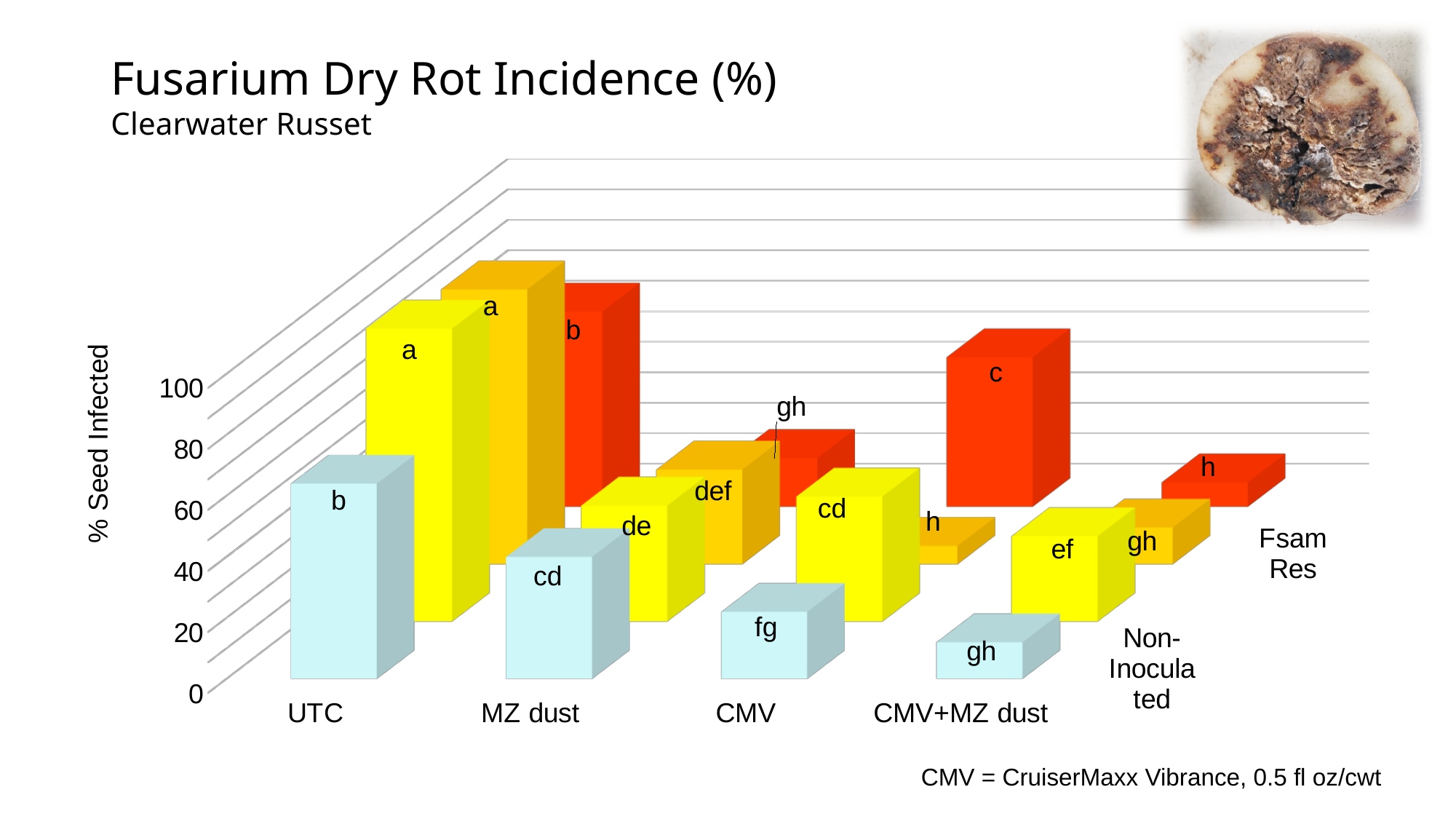
What kind of chart is shown on the slide? bar chart Which is larger, the Non-Inoculated value for UTC or for CMV? UTC Which treatment has the lowest Fsam Res bar? CMV Is the Non-Inoculated value for UTC greater or less than 40? greater How many treatment categories are shown along the x axis? 4 What is the title of the chart? Fusarium Dry Rot Incidence (%) Is the Non-Inoculated value for CMV+MZ dust greater or less than 40? less Which treatment has the highest Fsam Res bar? UTC Do the Non-Inoculated values rise or fall from UTC to CMV+MZ dust? fall What is the label on the vertical axis of the chart? % Seed Infected Which treatment has the lowest Non-Inoculated bar? CMV+MZ dust Which treatment has the highest Non-Inoculated bar? UTC